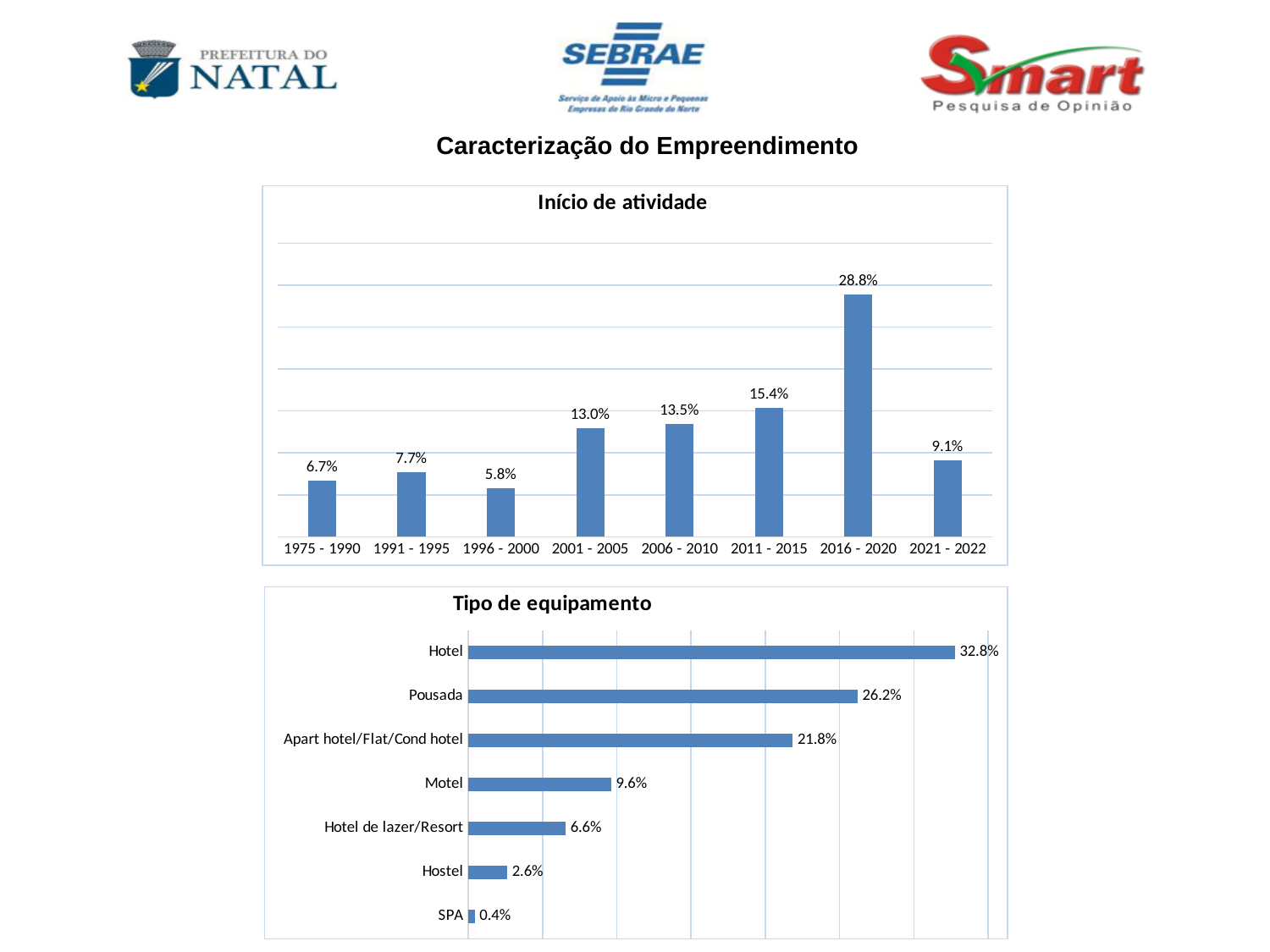
In the 'Início de atividade' chart, what is the value for 2016 - 2020? 28.8% In the 'Tipo de equipamento' chart, what is the difference between the values for Hotel and Apart hotel/Flat/Cond hotel? 11.0% In the 'Tipo de equipamento' chart, how many categories are shown? 7 In the 'Tipo de equipamento' chart, which category has the highest value? Hotel In the 'Tipo de equipamento' chart, what is the value for Pousada? 26.2% In the 'Início de atividade' chart, which period has the lowest value? 1996 - 2000 In the 'Início de atividade' chart, which period has the highest value? 2016 - 2020 In the 'Início de atividade' chart, how many periods are shown on the x axis? 8 In the 'Início de atividade' chart, what is the difference between the values for 2016 - 2020 and 2021 - 2022? 19.7% In the 'Tipo de equipamento' chart, which category has the lowest value? SPA What kind of chart is the 'Tipo de equipamento' chart? Bar chart In the 'Início de atividade' chart, which is larger, the value for 1991 - 1995 or the value for 1975 - 1990? 1991 - 1995